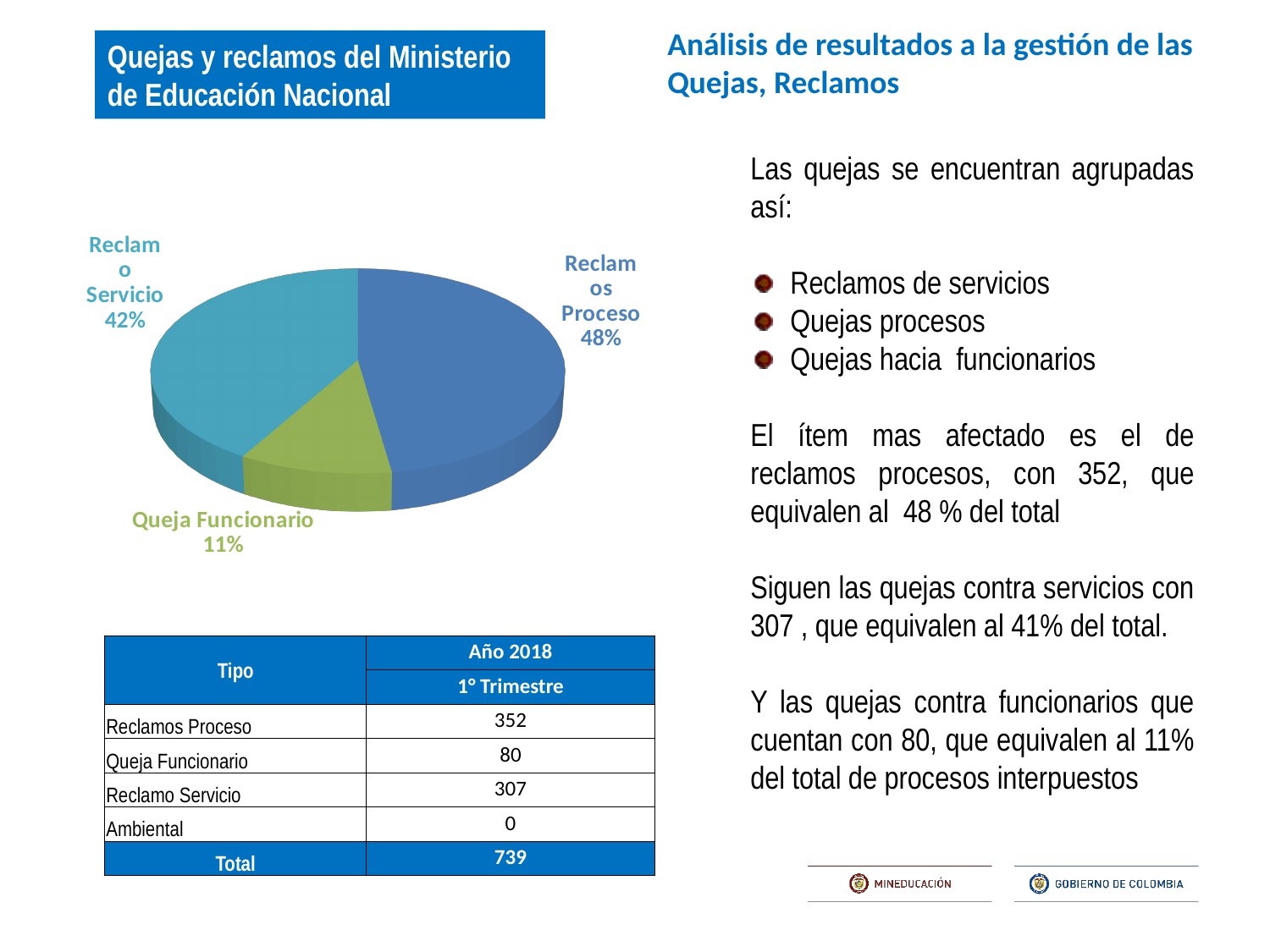
What colour is the Queja Funcionario slice in the pie chart? green What share of the pie does Reclamos Proceso represent? 48% What share of the pie does Reclamo Servicio represent? 42% What share of the pie does Queja Funcionario represent? 11% Which category has the smallest slice of the pie chart? Queja Funcionario How many slices does the pie chart have? 3 What kind of chart is shown on the slide? pie chart Which category has the largest slice of the pie chart? Reclamos Proceso By how many percentage points does the Reclamos Proceso share exceed the Reclamo Servicio share? 6 By how many percentage points does the Reclamo Servicio share exceed the Queja Funcionario share? 31 Which slice is larger, Queja Funcionario or Reclamo Servicio? Reclamo Servicio Which slice is larger, Reclamos Proceso or Reclamo Servicio? Reclamos Proceso